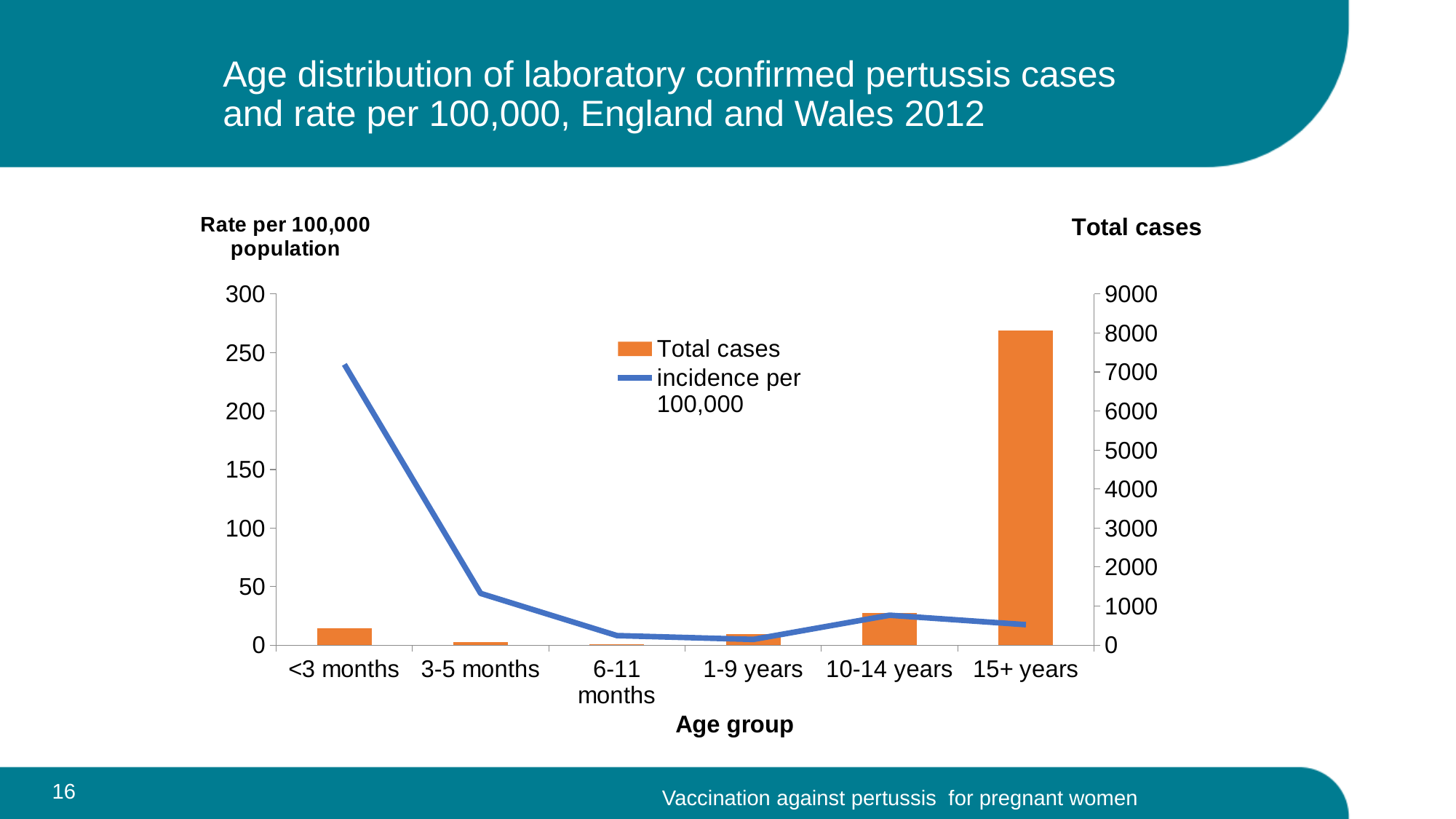
Is the number of total cases for 15+ years greater or less than 7000? greater Does the incidence per 100,000 rise or fall from <3 months to 6-11 months? fall What kind of chart is shown on the slide? A combined bar and line chart How many age groups are shown on the x axis? 6 Is the incidence per 100,000 for <3 months greater or less than 200? greater Which has more total cases, <3 months or 3-5 months? <3 months Is the number of total cases for 10-14 years greater or less than 1000? less How many series does the legend list? 2 What colour are the bars for Total cases? Orange Which age group has the highest number of total cases? 15+ years Which age group has the highest incidence per 100,000? <3 months